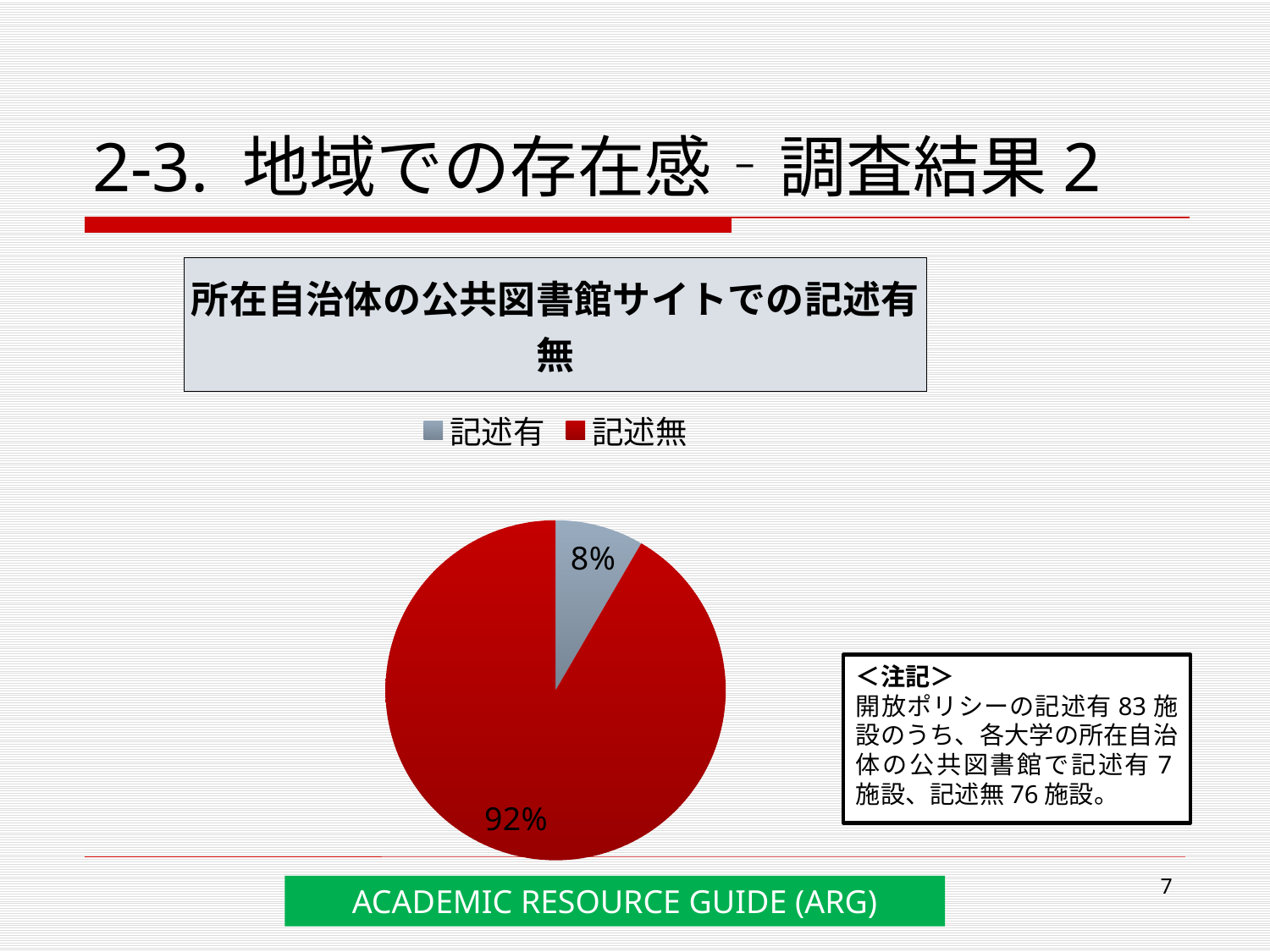
What percentage is shown for 記述無? 92% Which is larger, 記述有 or 記述無? 記述無 What percentage is shown for 記述有? 8% What kind of chart is shown on the slide? pie chart How many slices does the pie chart have? 2 Which slice is the largest? 記述無 Which slice is the smallest? 記述有 What share of the pie does 記述有 take? 8% What is the difference in percentage points between 記述無 and 記述有? 84 What colour is the 記述無 slice? red How many entries does the legend list? 2 What is the chart's title? 所在自治体の公共図書館サイトでの記述有無